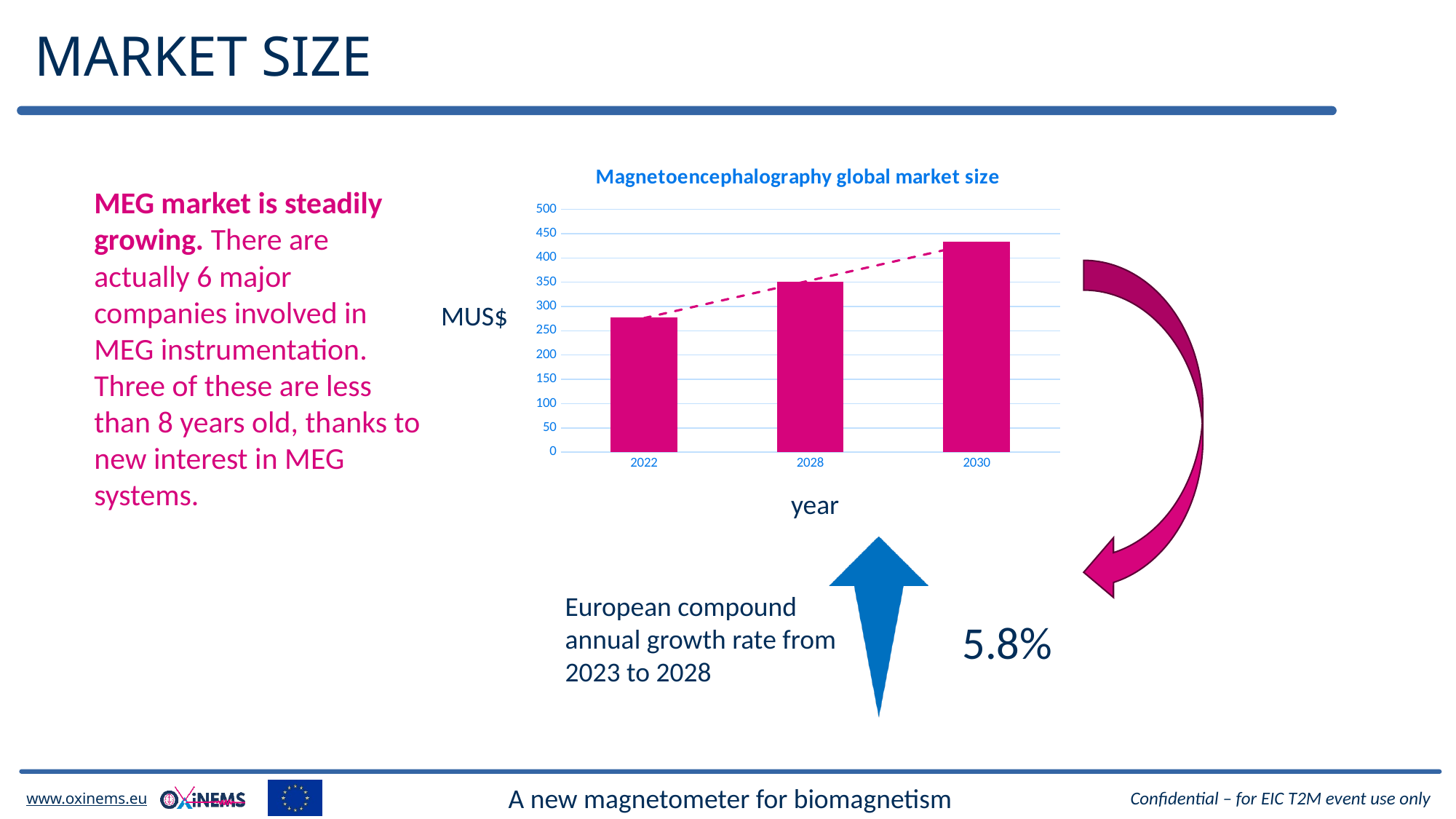
How many years (bars) are plotted in the chart? 3 Which is larger, the market size for 2028 or for 2022? 2028 Is the market size for 2022 greater or less than 250? greater What unit is shown on the y axis of the chart? MUS$ Which year has the highest market size in the chart? 2030 Which year has the lowest market size in the chart? 2022 Do the values rise or fall from 2022 to 2030 along the x axis? rise Is the market size for 2030 greater or less than 450? less Is the market size for 2022 greater or less than 300? less What is the title of the chart? Magnetoencephalography global market size What type of chart is shown on the slide? bar chart